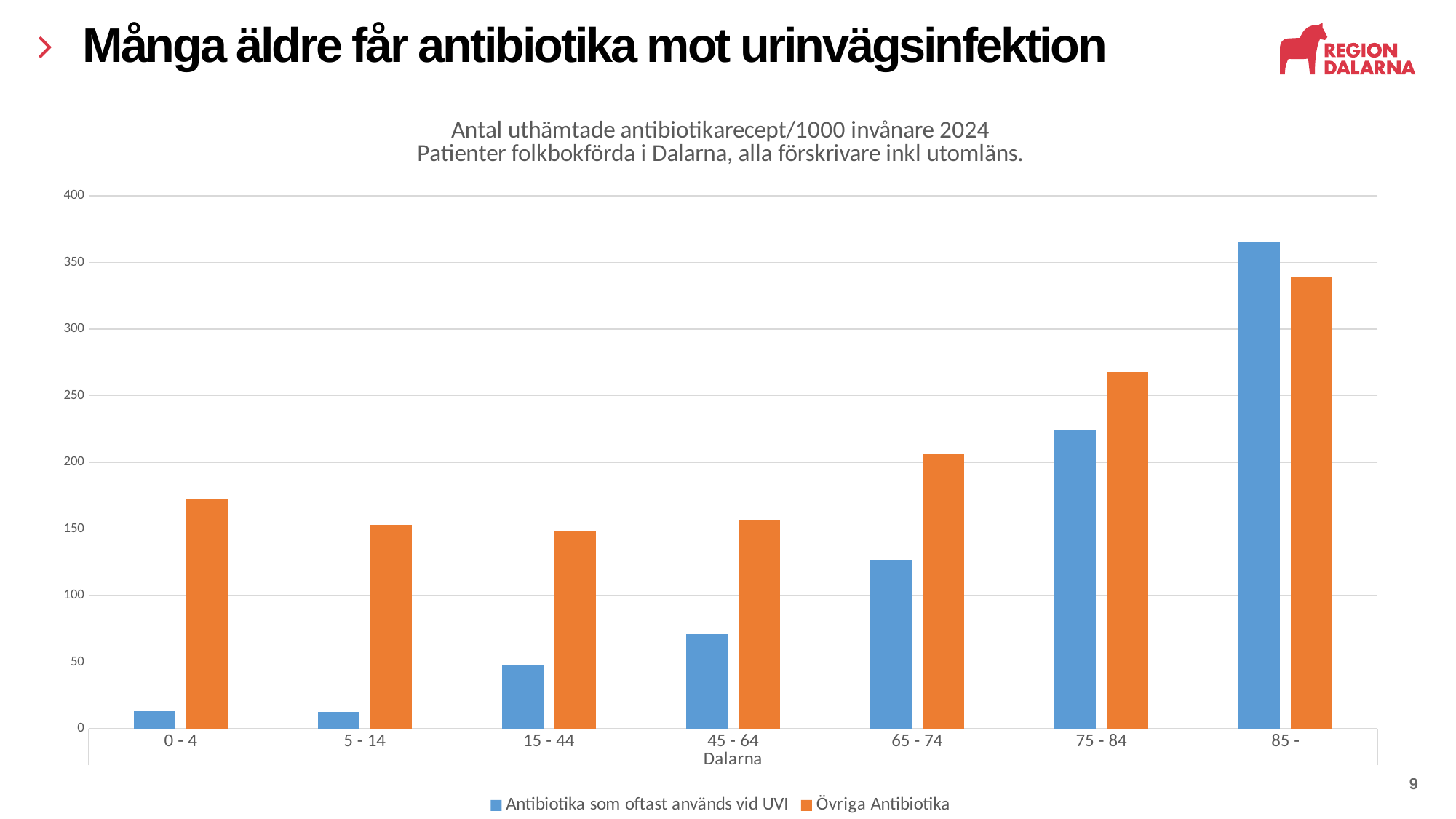
In the 85 - group, which series has the larger value: Antibiotika som oftast används vid UVI or Övriga Antibiotika? Antibiotika som oftast används vid UVI Is the value for Antibiotika som oftast används vid UVI in the 45 - 64 group greater or less than 100? less Which age group has the highest value for Övriga Antibiotika? 85 - Which age group has the highest value for Antibiotika som oftast används vid UVI? 85 - Is the value for Antibiotika som oftast används vid UVI in the 75 - 84 group greater or less than 200? greater How many age groups are shown on the x axis? 7 In the 0 - 4 group, which series has the larger value: Antibiotika som oftast används vid UVI or Övriga Antibiotika? Övriga Antibiotika What kind of chart is shown on the slide? bar chart How many series does the legend list? 2 Is the value for Antibiotika som oftast används vid UVI in the 85 - group greater or less than 350? greater Do the values for Antibiotika som oftast används vid UVI generally rise or fall from the 0 - 4 group to the 85 - group? rise